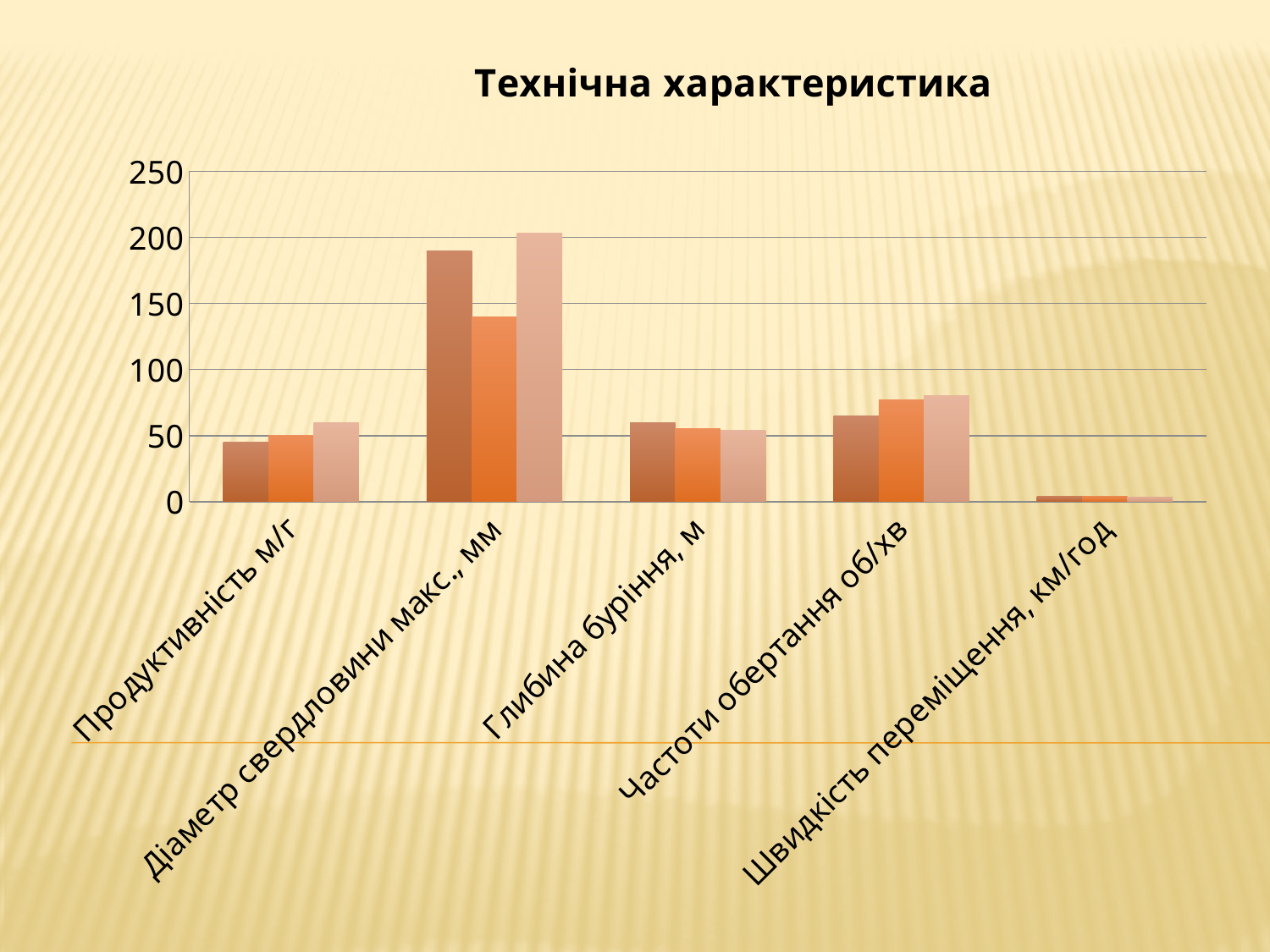
How many bars are plotted for each category in the chart? 3 What kind of chart is shown on the slide? bar chart Which is larger: the first (darkest) bar for Діаметр свердловини макс., мм or the first (darkest) bar for Глибина буріння, м? Діаметр свердловини макс., мм Within Діаметр свердловини макс., мм, which is larger: the first (darkest) bar or the second (orange) bar? the first (darkest) bar Are the values for Швидкість переміщення, км/год greater or less than 50? less What is the title of the chart? Технічна характеристика Which category has the shortest bars in the chart? Швидкість переміщення, км/год Which category has the tallest bars in the chart? Діаметр свердловини макс., мм Is the value of the first (darkest) bar for Продуктивність м/г greater or less than 50? less Is the value of the third (lightest) bar for Частоти обертання об/хв greater or less than 50? greater How many categories are shown on the x axis of the chart? 5